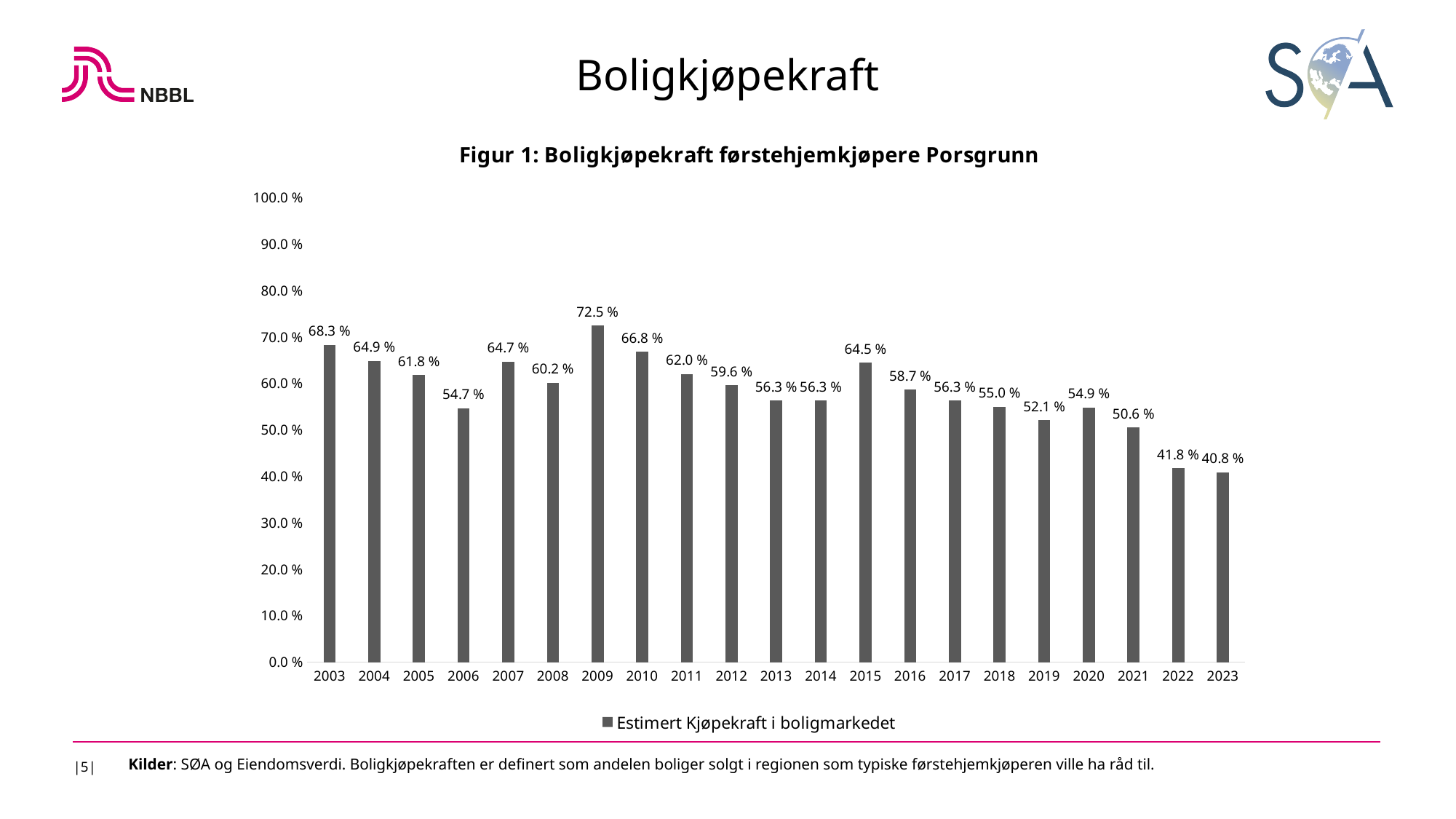
Which year has the highest value? 2009 Which is larger, the value for 2010 or the value for 2011? 2010 How many series does the legend list? 1 Is the value for 2022 greater or less than 50.0 %? less What is the value for 2015? 64.5 % What is the value for 2023? 40.8 % What is the value for 2009? 72.5 % What kind of chart is shown? bar chart What is the difference between the values for 2003 and 2006? 13.6 % What is the difference between the values for 2009 and 2023? 31.7 % Which year has the lowest value? 2023 How many years are shown on the x axis? 21